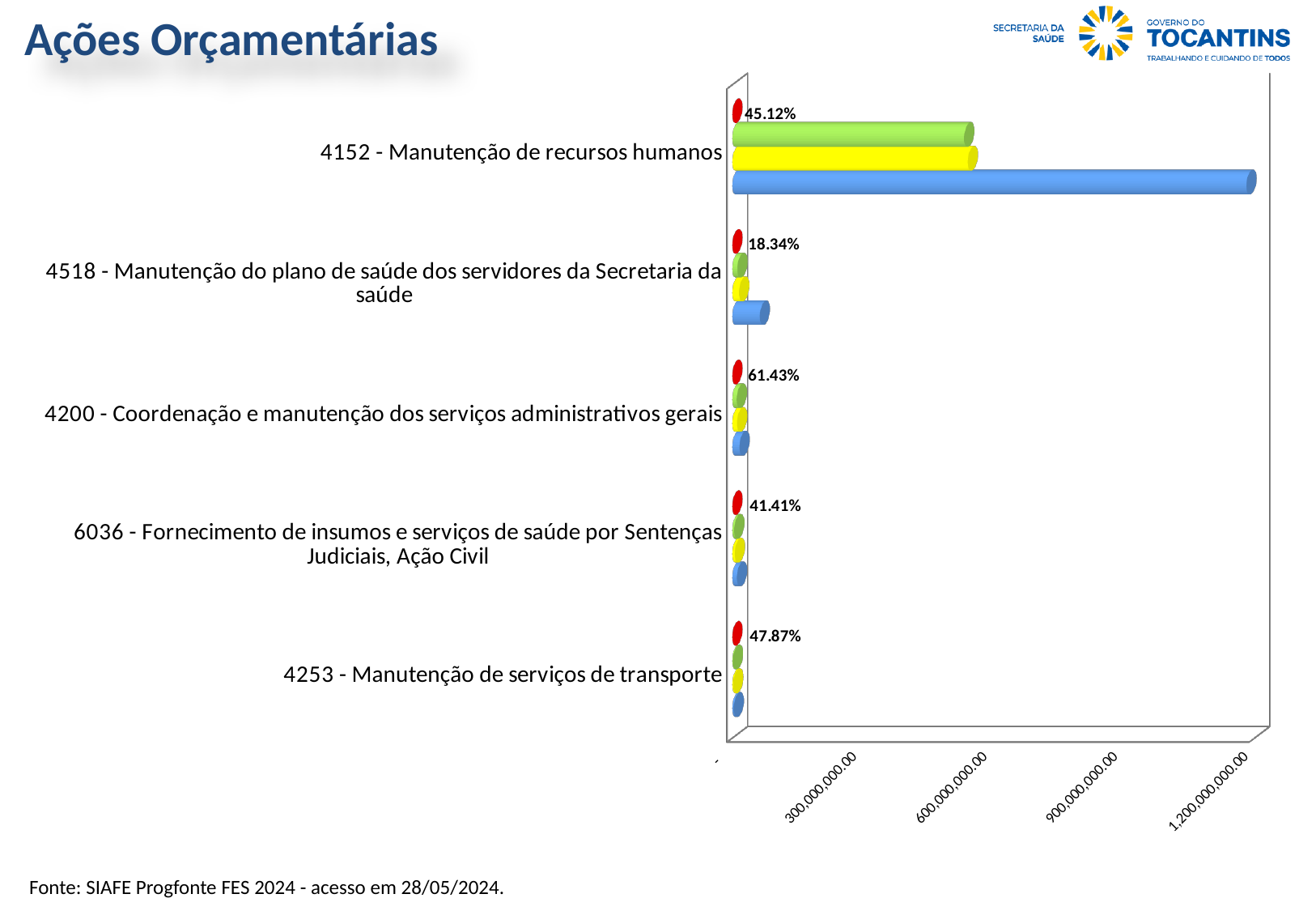
How many categories (budget actions) are shown on the chart? 5 What percentage label is shown for 4152 - Manutenção de recursos humanos? 45.12% What percentage label is shown for 4200 - Coordenação e manutenção dos serviços administrativos gerais? 61.43% What percentage label is shown for 6036 - Fornecimento de insumos e serviços de saúde por Sentenças Judiciais, Ação Civil? 41.41% Is the value of the blue bar for 4152 - Manutenção de recursos humanos greater or less than 900,000,000.00? greater What percentage label is shown for 4518 - Manutenção do plano de saúde dos servidores da Secretaria da saúde? 18.34% Which category has the highest percentage label? 4200 - Coordenação e manutenção dos serviços administrativos gerais Is the value of the green bar for 4152 - Manutenção de recursos humanos greater or less than 600,000,000.00? less What is the difference between the percentage labels for 4200 - Coordenação e manutenção dos serviços administrativos gerais and 4518 - Manutenção do plano de saúde dos servidores da Secretaria da saúde? 43.09% Which category has the lowest percentage label? 4518 - Manutenção do plano de saúde dos servidores da Secretaria da saúde What kind of chart is shown on the slide? Bar chart What percentage label is shown for 4253 - Manutenção de serviços de transporte? 47.87%